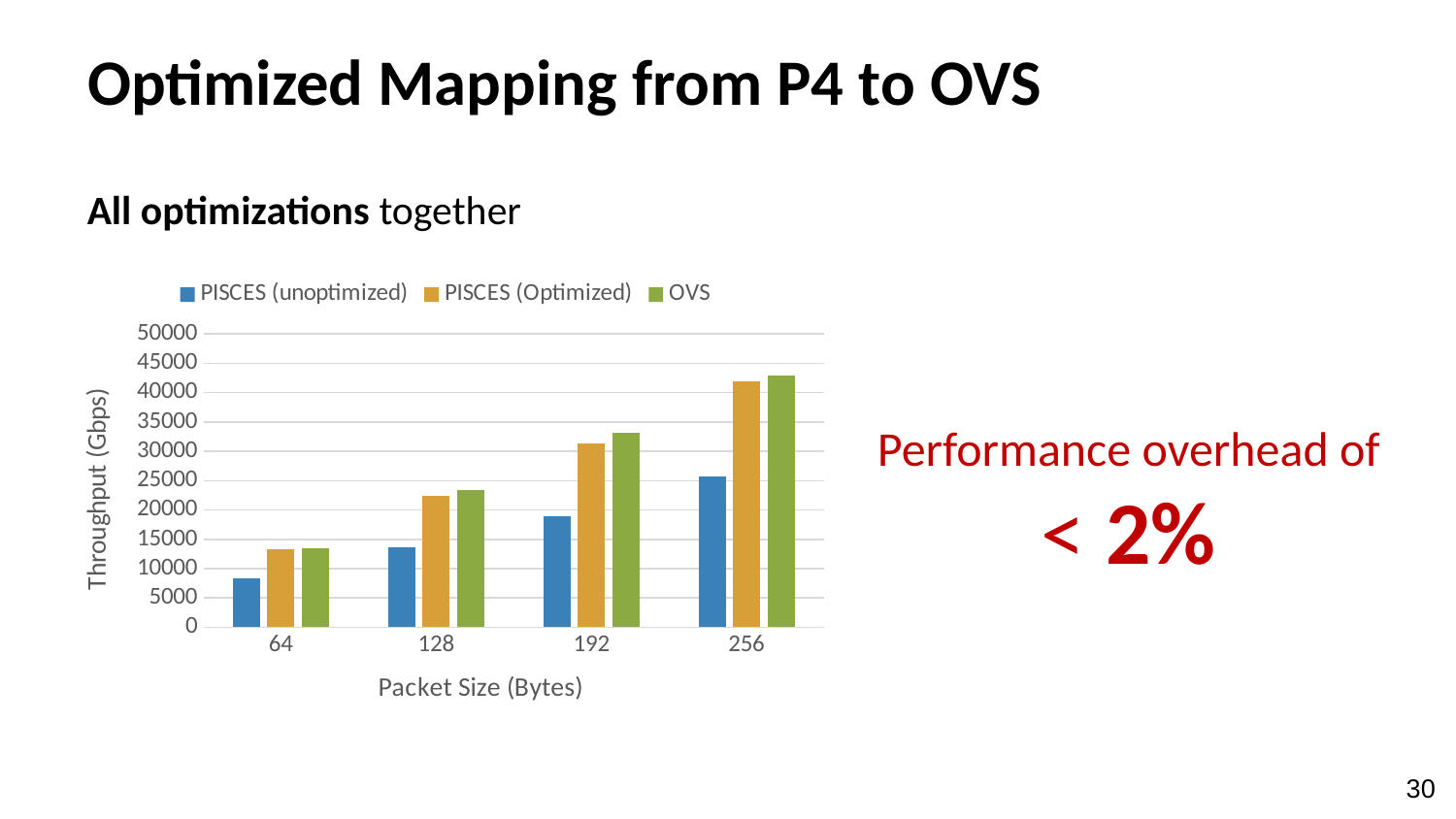
Is the PISCES (unoptimized) throughput at packet size 64 greater or less than 10000? less At which packet size is the PISCES (unoptimized) throughput lowest? 64 How many series does the chart's legend list? 3 At which packet size is the OVS throughput highest? 256 What is the label of the chart's y axis? Throughput (Gbps) What kind of chart is shown on the slide? Bar chart How many packet size categories are shown on the x axis? 4 Is the PISCES (unoptimized) throughput at packet size 256 greater or less than 30000? less Is the PISCES (Optimized) throughput at packet size 128 greater or less than 20000? greater Does the OVS throughput rise or fall as packet size increases along the x axis? Rises At packet size 192, which is larger: PISCES (unoptimized) or PISCES (Optimized)? PISCES (Optimized)